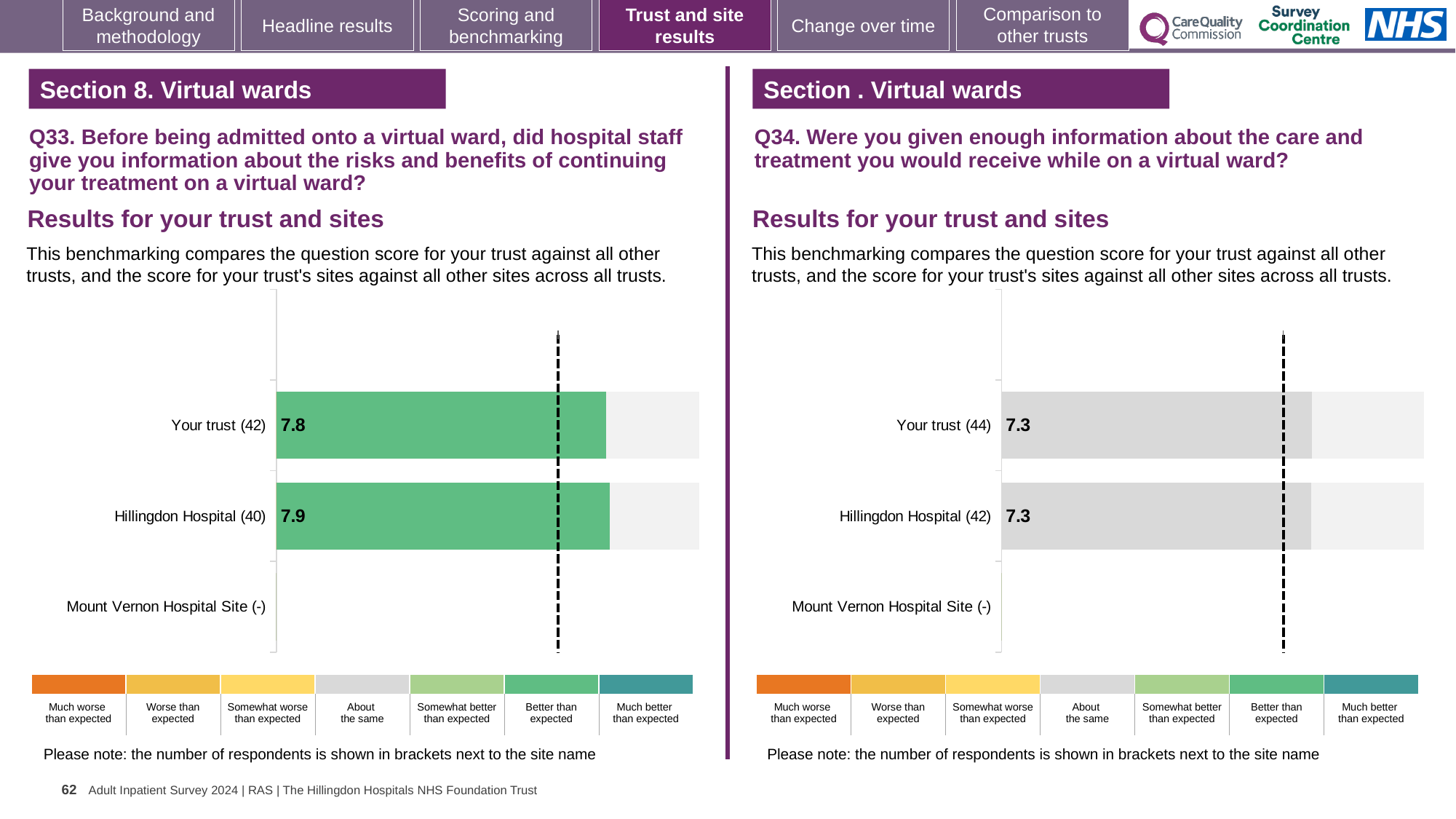
In the Q33 chart on the left, what is the difference between the Hillingdon Hospital score and the Your trust score? 0.1 According to the colour key, which benchmark category does the grey colour of the bars in the Q34 chart on the right represent? About the same According to the colour key, which benchmark category does the green colour of the bars in the Q33 chart on the left represent? Better than expected In the Q34 chart on the right, how many respondents are shown in brackets for Your trust? 44 In the Q34 chart on the right, what is the score for Hillingdon Hospital? 7.3 How many site/trust categories are listed on the y axis of the Q33 chart on the left? 3 What kind of chart is used for the Q34 results on the right? Bar chart In the Q33 chart on the left, what is the score for Hillingdon Hospital? 7.9 In the Q33 chart on the left, which has the higher score, Your trust or Hillingdon Hospital? Hillingdon Hospital In the Q33 chart on the left, what is the score for Your trust? 7.8 In the Q34 chart on the right, what is the score for Your trust? 7.3 In the Q33 chart on the left, how many respondents are shown in brackets for Hillingdon Hospital? 40